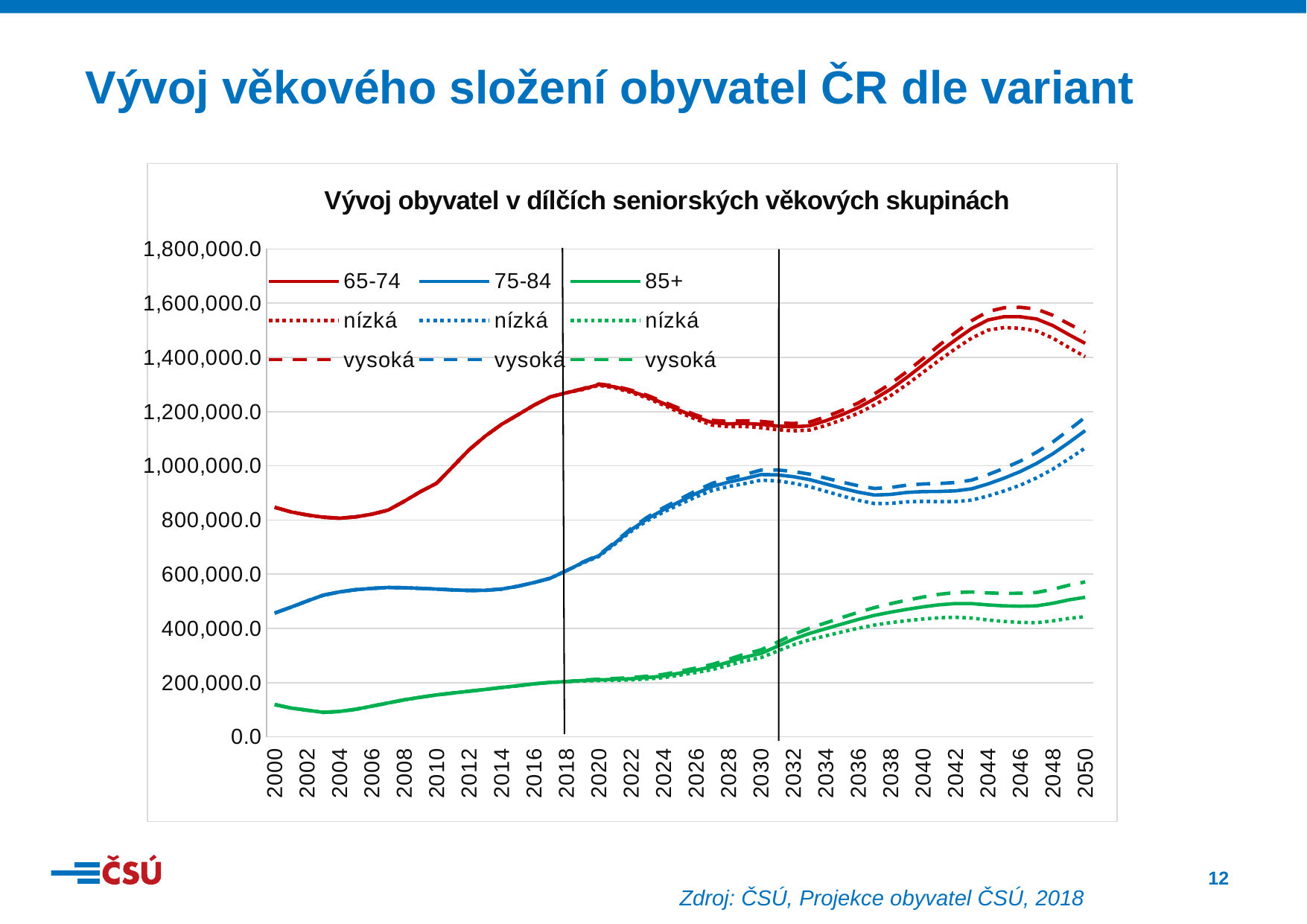
Is the value for the 85+ group in 2000 greater or less than 200,000.0? less Which colour is used for the 65-74 age group lines? red Is the value for the 85+ group in 2050 greater or less than 400,000.0? greater How many series does the chart legend list? 9 Is the value for the 75-84 group in 2050 greater or less than 1,000,000.0? greater Which age group has the highest values across the whole period 2000-2050? 65-74 What kind of chart is shown on the slide? line chart What is the title of the chart? Vývoj obyvatel v dílčích seniorských věkových skupinách Does the 85+ group line rise or fall overall from 2000 to 2050? rise Which age group has the lowest values across the whole period 2000-2050? 85+